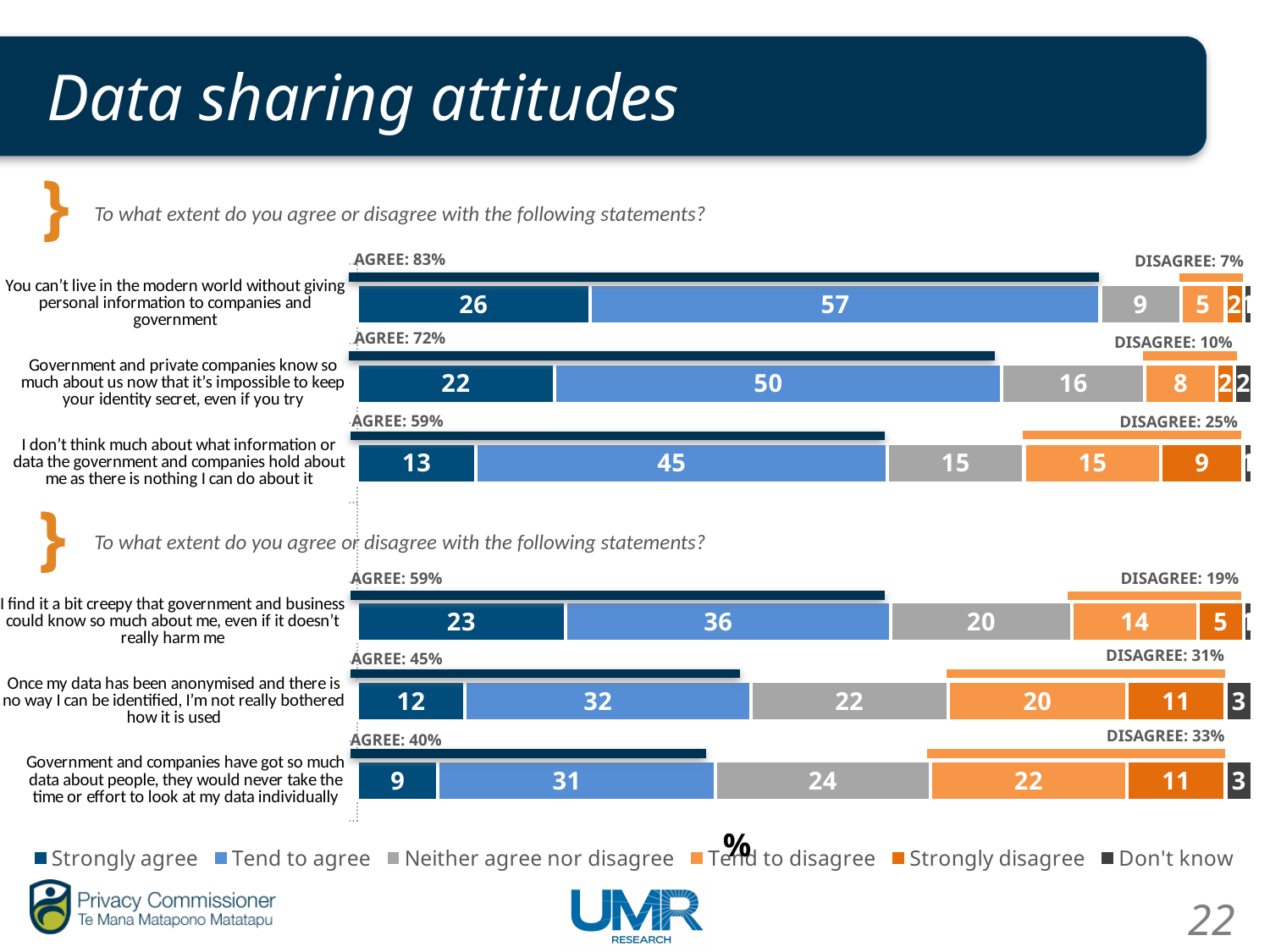
In the bottom chart, what is the overall DISAGREE figure for the statement 'Once my data has been anonymised and there is no way I can be identified, I'm not really bothered how it is used'? 31% How many series does the legend list? 6 In the bottom chart, which statement has the lowest 'Strongly agree' value? Government and companies have got so much data about people, they would never take the time or effort to look at my data individually In the top chart, what is the 'Tend to agree' value for the statement that government and private companies know so much about us now that it's impossible to keep your identity secret? 50 In the top chart, which statement has the highest 'Strongly agree' value? You can't live in the modern world without giving personal information to companies and government In the bottom chart, is the 'Tend to disagree' value larger for the 'creepy' statement or for the 'anonymised' statement? The anonymised statement What kind of chart is used on this slide? Stacked bar chart In the top chart, what is the overall AGREE figure shown for the statement 'I don't think much about what information or data the government and companies hold about me'? 59% In the bottom chart, what is the 'Neither agree nor disagree' value for the statement that government and companies have got so much data about people they would never look at my data individually? 24 How many statements are plotted in the bottom chart? 3 In the top chart, what percentage strongly agree that you can't live in the modern world without giving personal information to companies and government? 26 In the top chart, what is the difference between the 'Tend to agree' values for the first statement (57) and the third statement (45)? 12